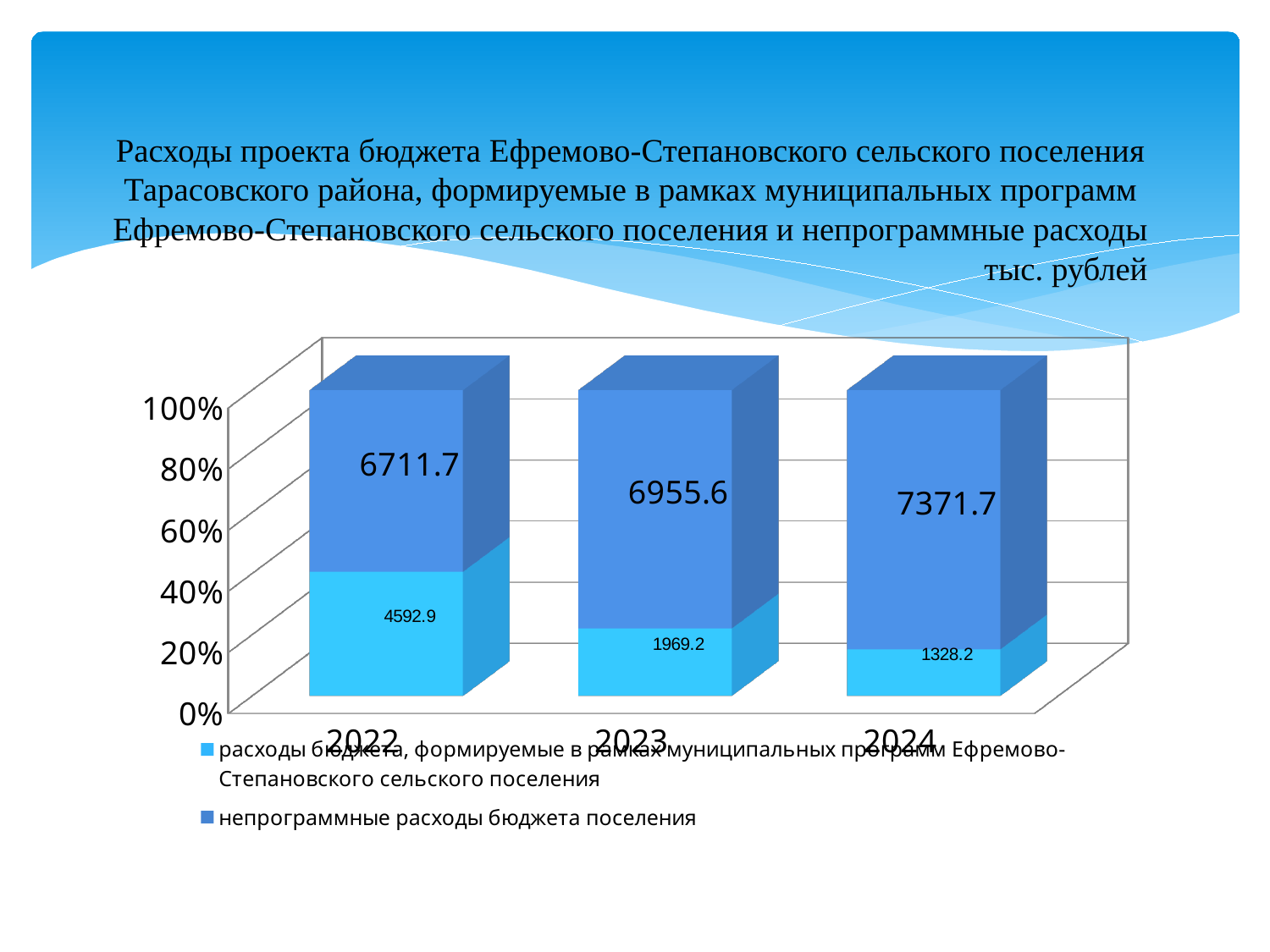
What is the value of расходы бюджета, формируемые в рамках муниципальных программ for 2024? 1328.2 How many series does the legend list? 2 In which year is the value of расходы бюджета, формируемые в рамках муниципальных программ the lowest? 2024 What is the difference between непрограммные расходы бюджета поселения in 2024 and in 2023? 416.1 What is the value of непрограммные расходы бюджета поселения for 2022? 6711.7 In which year is the value of непрограммные расходы бюджета поселения the highest? 2024 What kind of chart is shown on the slide? Stacked bar chart How many years are shown on the x axis of the chart? 3 Which is larger: расходы бюджета, формируемые в рамках муниципальных программ in 2022 or in 2023? 2022 What is the value of расходы бюджета, формируемые в рамках муниципальных программ for 2023? 1969.2 Do the values of расходы бюджета, формируемые в рамках муниципальных программ rise or fall from 2022 to 2024? Fall What is the total of the two series for 2022? 11304.6